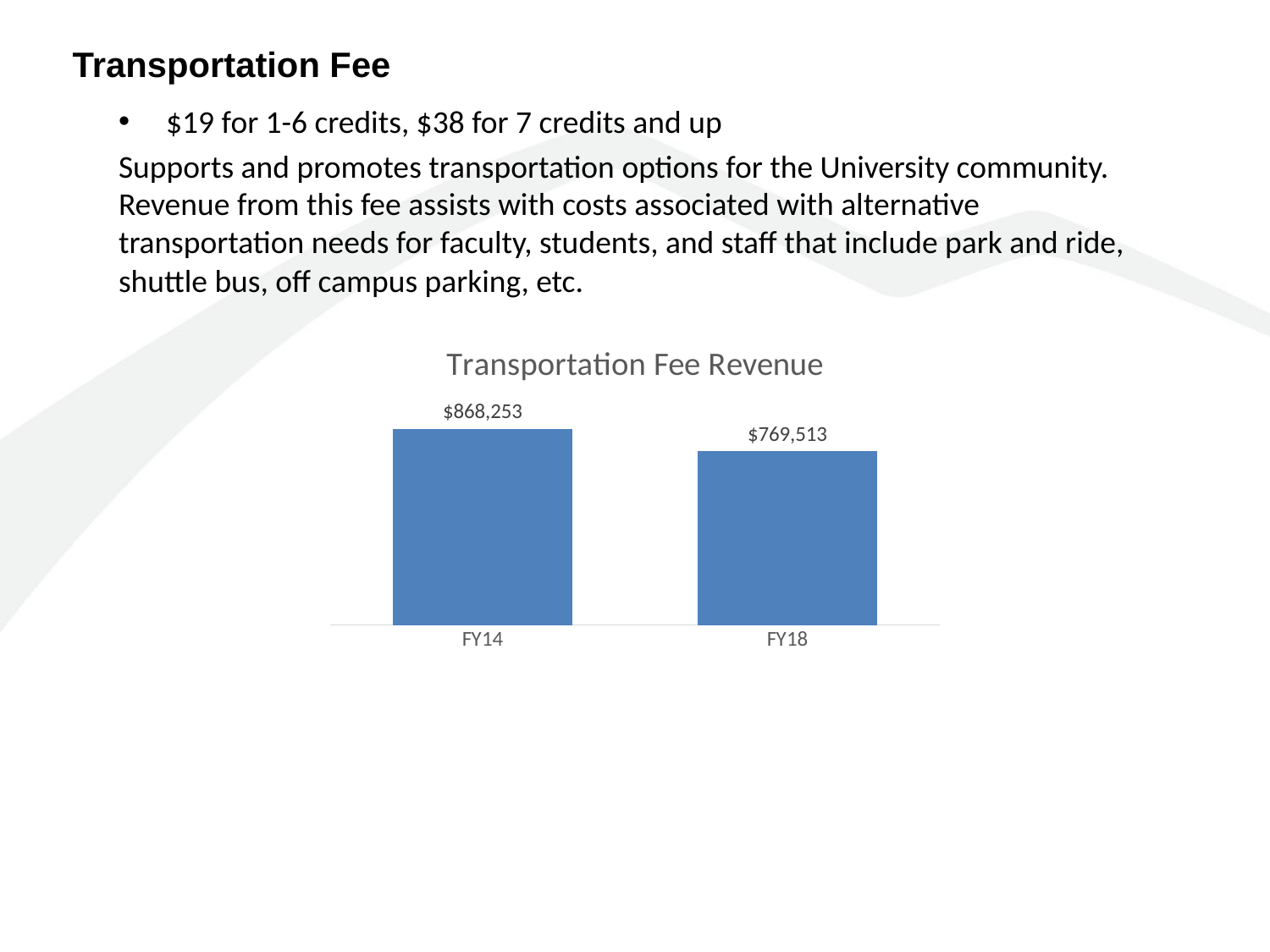
What is the title of the chart on the slide? Transportation Fee Revenue What is the Transportation Fee Revenue for FY14? $868,253 Does the Transportation Fee Revenue rise or fall from FY14 to FY18? Fall Is the Transportation Fee Revenue larger in FY14 or FY18? FY14 What kind of chart is used to show Transportation Fee Revenue? Bar chart Which fiscal year has the lowest Transportation Fee Revenue? FY18 Which fiscal year has the highest Transportation Fee Revenue? FY14 How many fiscal years are shown in the Transportation Fee Revenue chart? 2 What is the Transportation Fee Revenue for FY18? $769,513 What is the total Transportation Fee Revenue across FY14 and FY18 combined? $1,637,766 What is the difference between the FY14 and FY18 Transportation Fee Revenue? $98,740